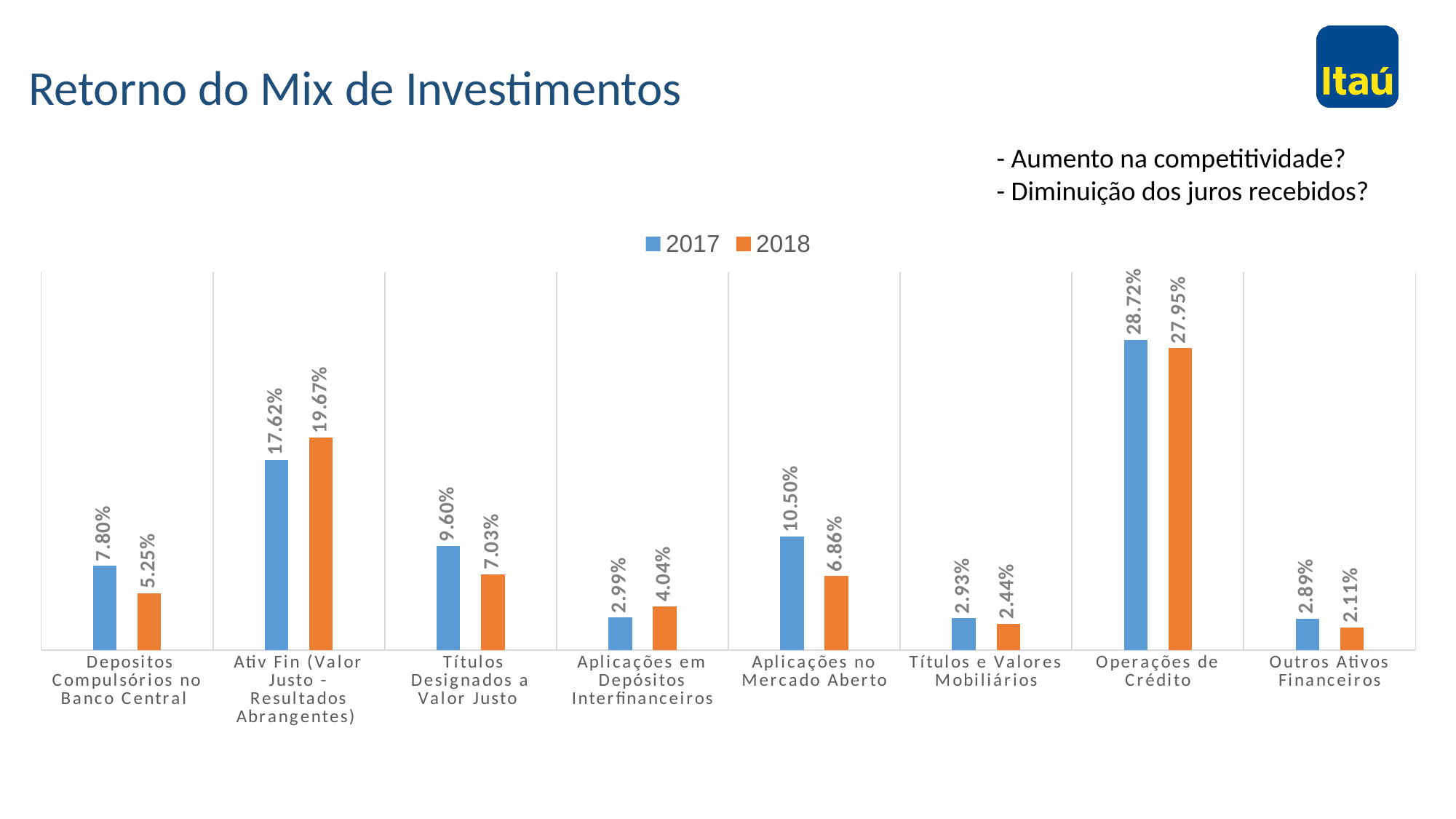
For Aplicações em Depósitos Interfinanceiros, which year has the larger value, 2017 or 2018? 2018 What is the 2017 value for Operações de Crédito? 28.72% What is the 2018 value for Aplicações no Mercado Aberto? 6.86% How many categories are shown on the x axis? 8 What is the difference between the 2017 and 2018 values for Depositos Compulsórios no Banco Central? 2.55% Which category has the lowest 2018 value? Outros Ativos Financeiros What is the 2017 value for Títulos Designados a Valor Justo? 9.60% How many series does the legend list? 2 Which category has the highest 2018 value? Operações de Crédito Which colour represents the 2018 series in the chart? Orange What kind of chart is shown on the slide? Bar chart What is the 2018 value for Ativ Fin (Valor Justo - Resultados Abrangentes)? 19.67%